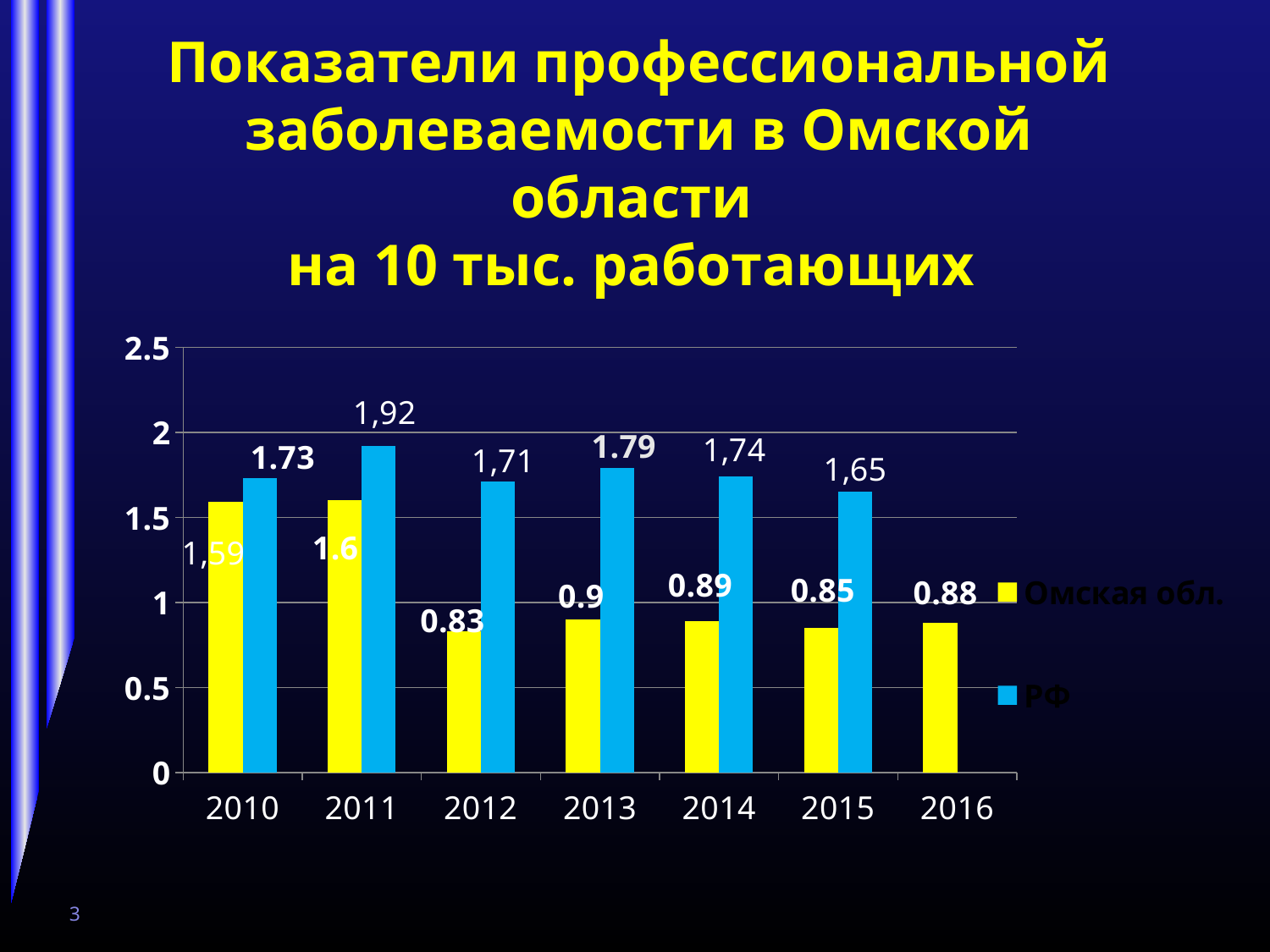
In which year is the Омская обл. value lowest? 2012 What is the value for Омская обл. in 2016? 0.88 Which series is shown in yellow? Омская обл. What is the value for РФ in 2011? 1,92 How many years are shown on the x axis? 7 In which year is the РФ value highest? 2011 How many series does the legend list? 2 What type of chart is shown on the slide? bar chart What is the difference between the РФ and Омская обл. values in 2011? 0.32 Which is larger in 2013, the value for Омская обл. or for РФ? РФ What is the value for Омская обл. in 2012? 0.83 What is the value for РФ in 2015? 1,65